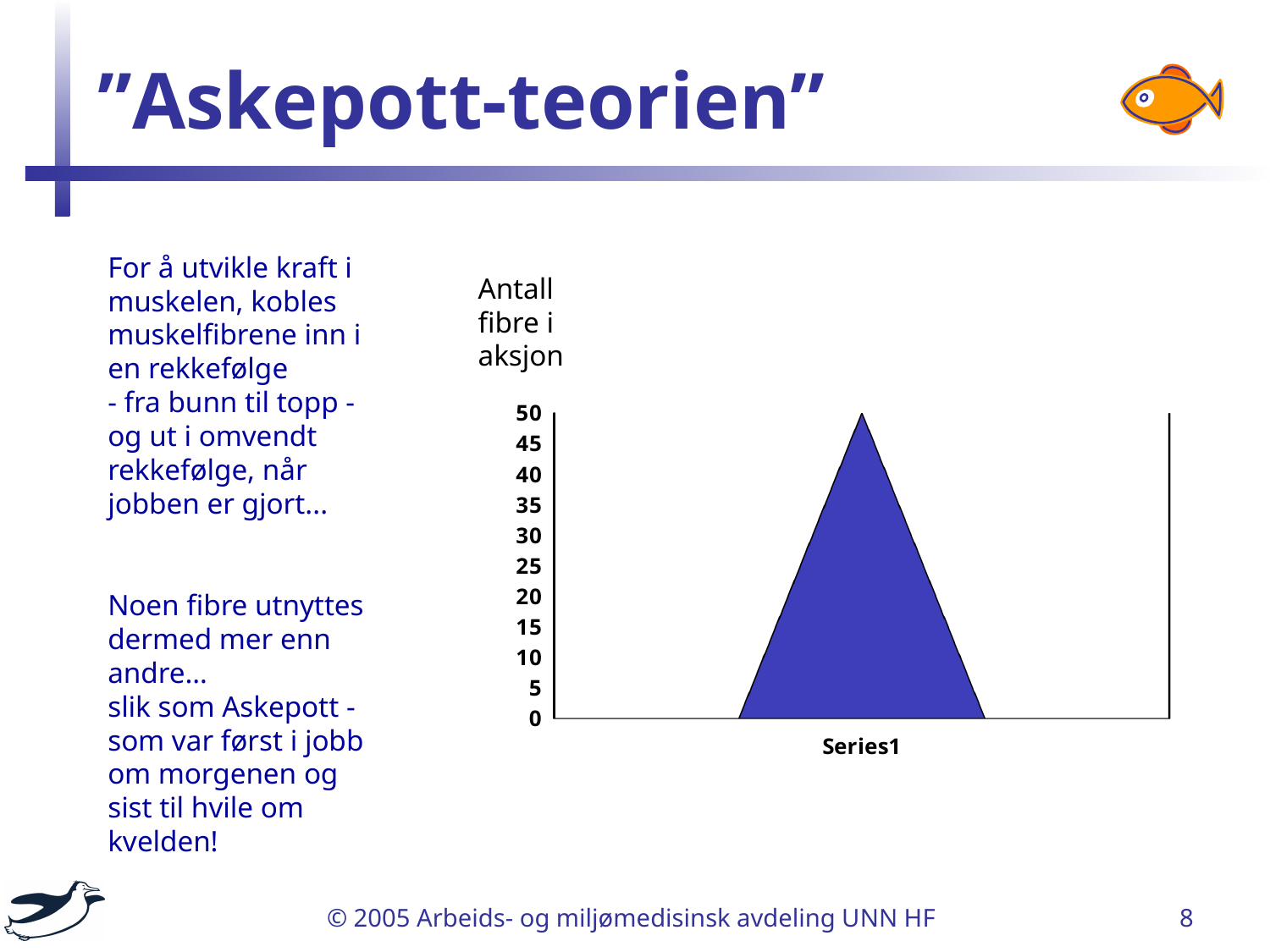
Is the peak of the plotted area greater or less than 40? greater What label is shown under the x axis? Series1 What value does the plotted area start and end at on the y axis? 0 What is the step between consecutive tick values on the y axis? 5 What is the highest tick value on the y axis? 50 What is the lowest value shown on the y axis? 0 What kind of chart is shown on the slide? bar chart Is the peak of the plotted area greater or less than 25? greater What is the highest value reached by the plotted area? 50